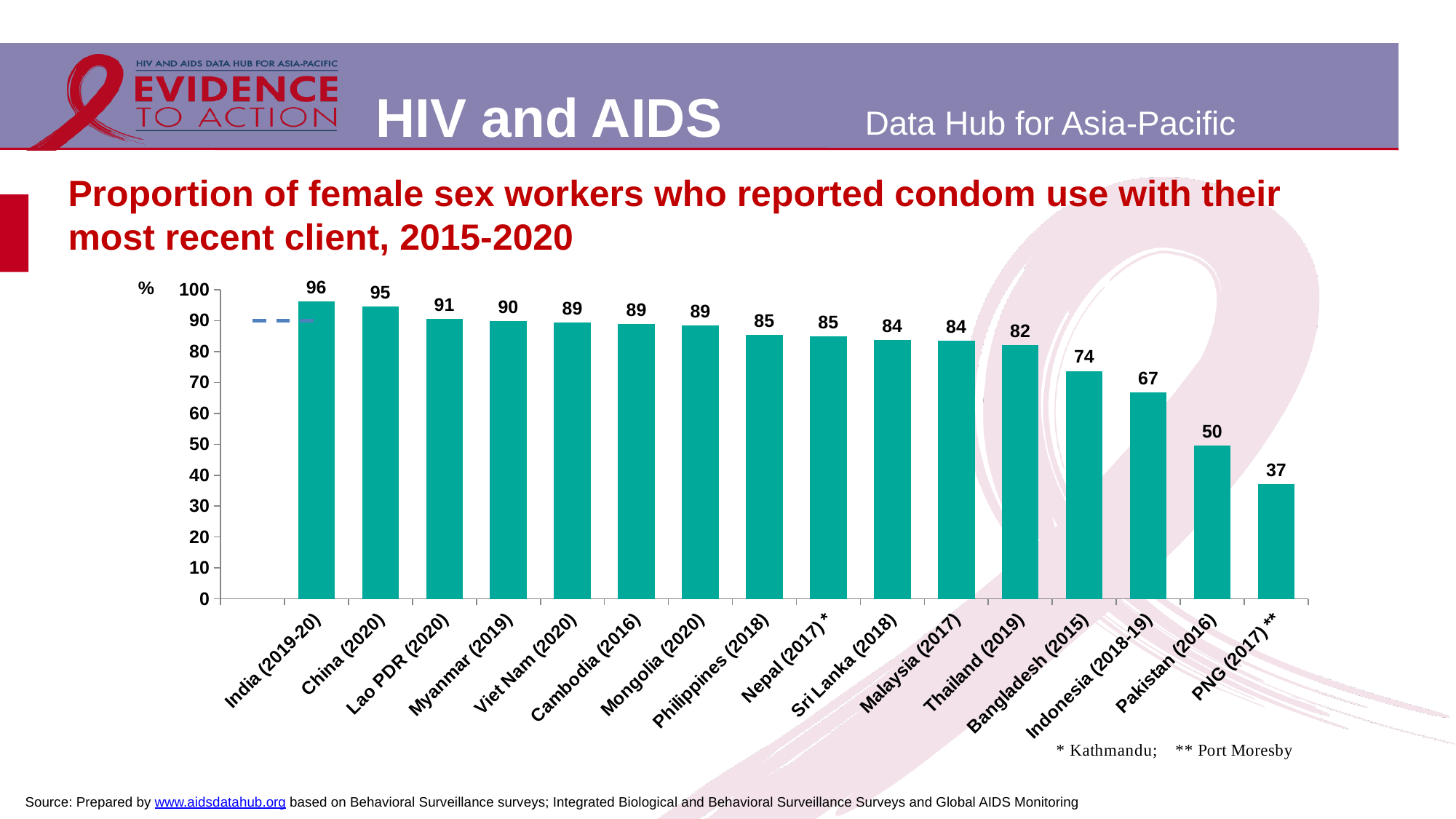
What is the value for Indonesia (2018-19)? 67 Which country has the lowest proportion? PNG (2017) Which country has the highest proportion? India (2019-20) What is the title of the chart? Proportion of female sex workers who reported condom use with their most recent client, 2015-2020 What kind of chart is shown on the slide? Bar chart Which is larger, the value for Bangladesh (2015) or the value for Malaysia (2017)? Malaysia (2017) Do the values rise or fall from left to right along the x axis? Fall What is the difference between the values for China (2020) and Pakistan (2016)? 45 What is the value for Thailand (2019)? 82 What is the value for India (2019-20)? 96 How many countries are shown on the chart? 16 What is the difference between the values for Lao PDR (2020) and PNG (2017)? 54